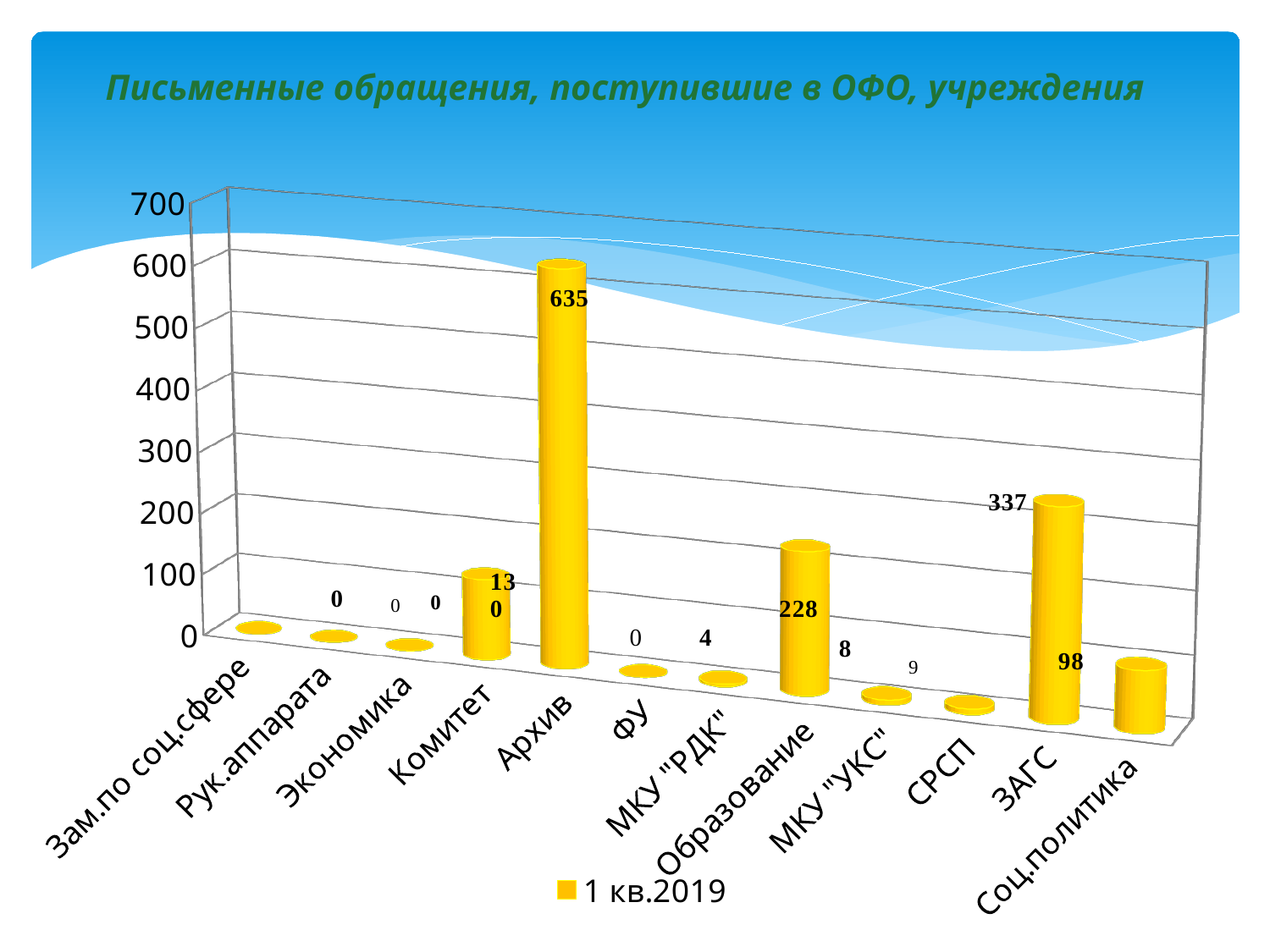
What is the value for Архив? 635 Which is larger, the value for ЗАГС or the value for Образование? ЗАГС What is the difference between the values for ЗАГС and Образование? 109 Is the value for Архив greater or less than 600? greater What is the value for Образование? 228 Which category has the highest value? Архив What is the difference between the values for Архив and ЗАГС? 298 What kind of chart is shown on the slide? bar chart What is the value for МКУ "РДК"? 4 What is the value for Соц.политика? 98 How many categories are shown on the x axis? 12 What is the value for ЗАГС? 337